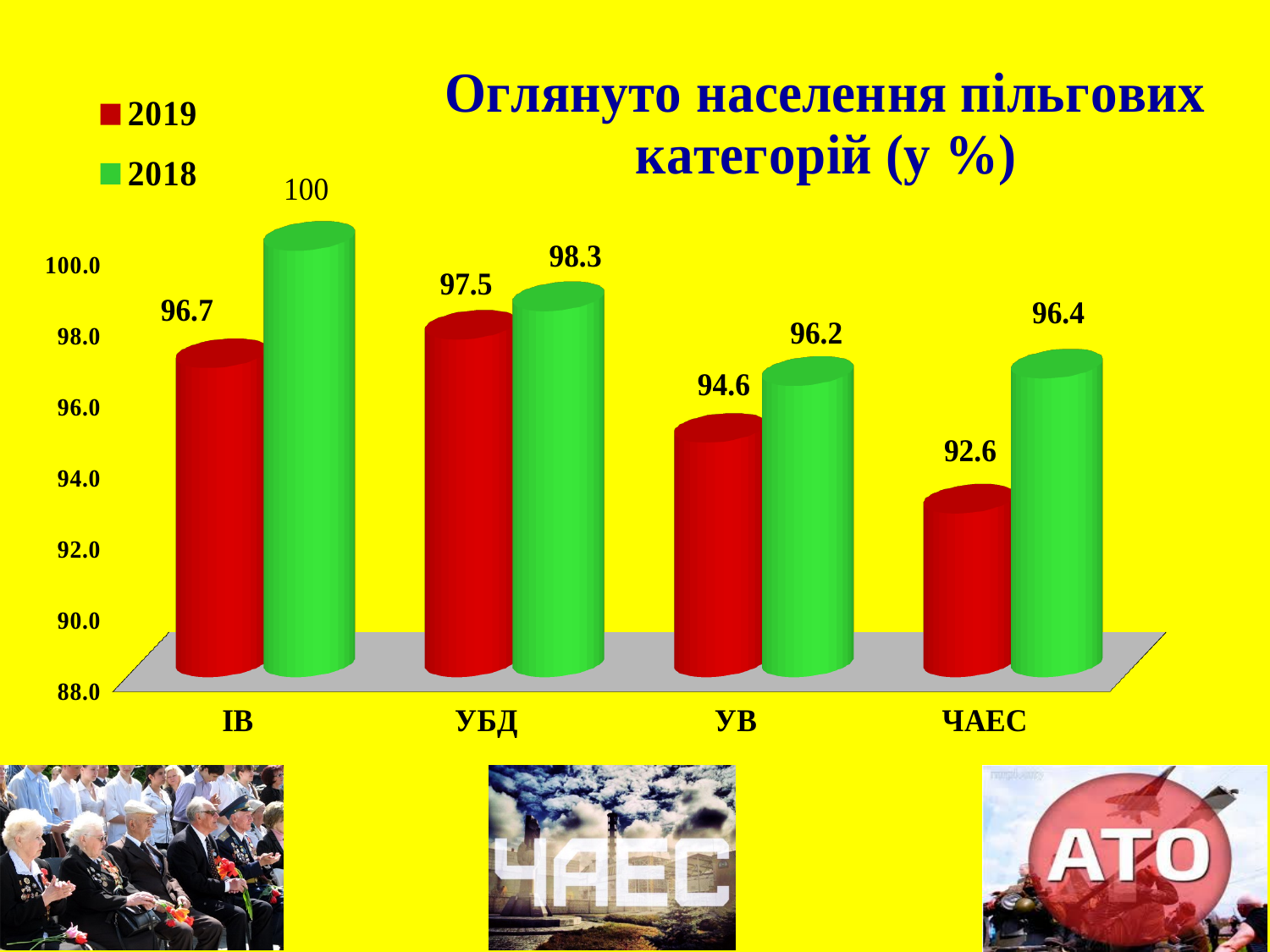
What type of chart is shown on the slide? bar chart What is the difference between the 2018 and 2019 values for ЧАЕС? 3.8 How many categories are shown on the x axis? 4 Is the 2019 value for УВ greater or less than 96.0? less Which category has the highest 2018 value? ІВ Which is larger for УБД: the 2019 value or the 2018 value? 2018 What is the 2019 value for ЧАЕС? 92.6 Which category has the lowest 2019 value? ЧАЕС What is the 2018 value for УВ? 96.2 What is the 2018 value for УБД? 98.3 How many series does the legend list? 2 What is the 2019 value for ІВ? 96.7